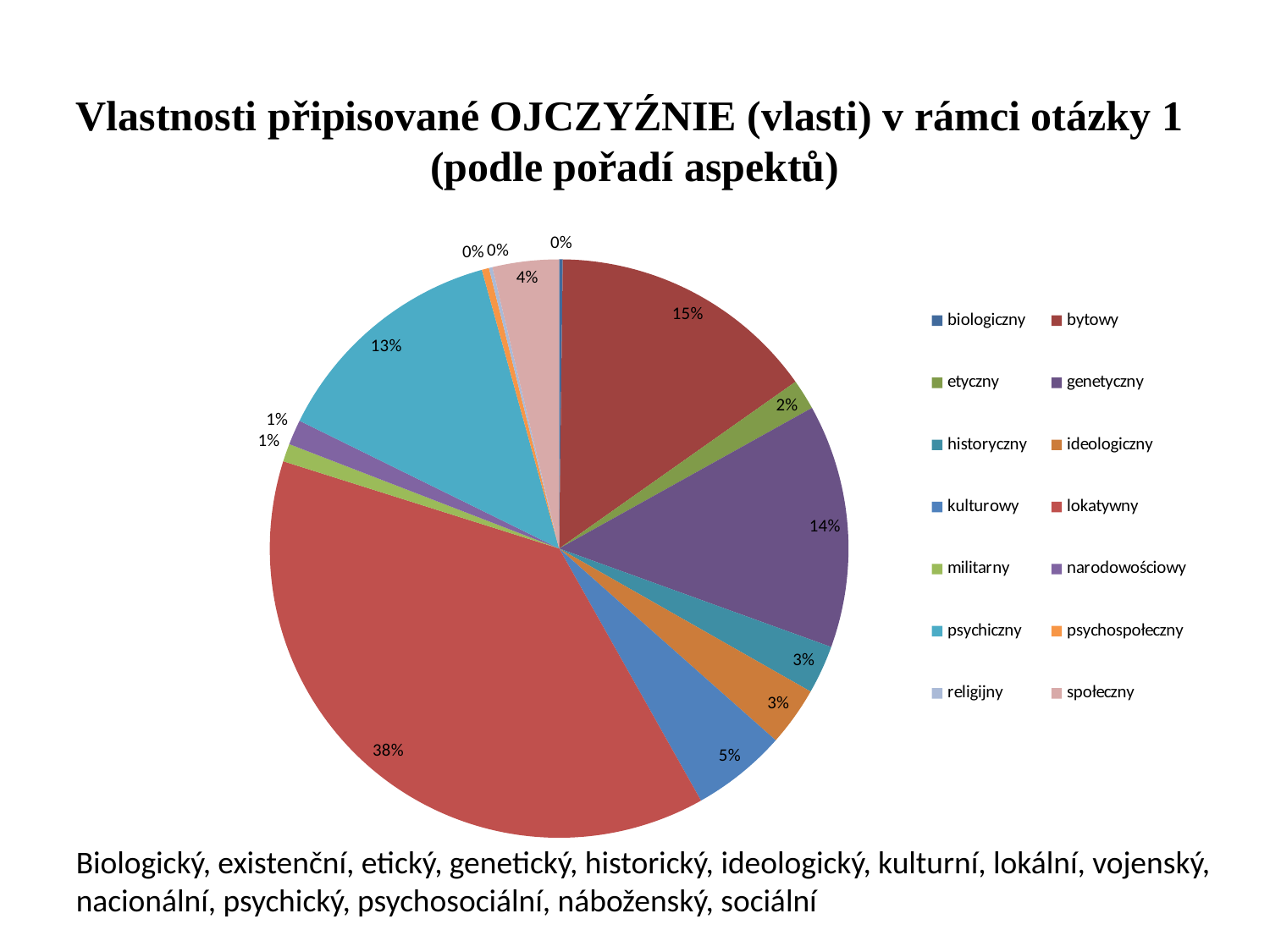
What percentage is shown for the kulturowy slice? 5% What percentage is shown for the bytowy slice? 15% What percentage is shown for the genetyczny slice? 14% How many categories does the legend list? 14 What kind of chart is shown on the slide? Pie chart What percentage is shown for the psychiczny slice? 13% What share of the pie does the lokatywny slice represent? 38% What percentage is shown for the społeczny slice? 4% What is the difference in percentage points between the lokatywny slice and the bytowy slice? 23 percentage points Which slice is larger, bytowy or genetyczny? bytowy Which category has the largest slice of the pie? lokatywny What is the title of the chart? Vlastnosti připisované OJCZYŹNIE (vlasti) v rámci otázky 1 (podle pořadí aspektů)